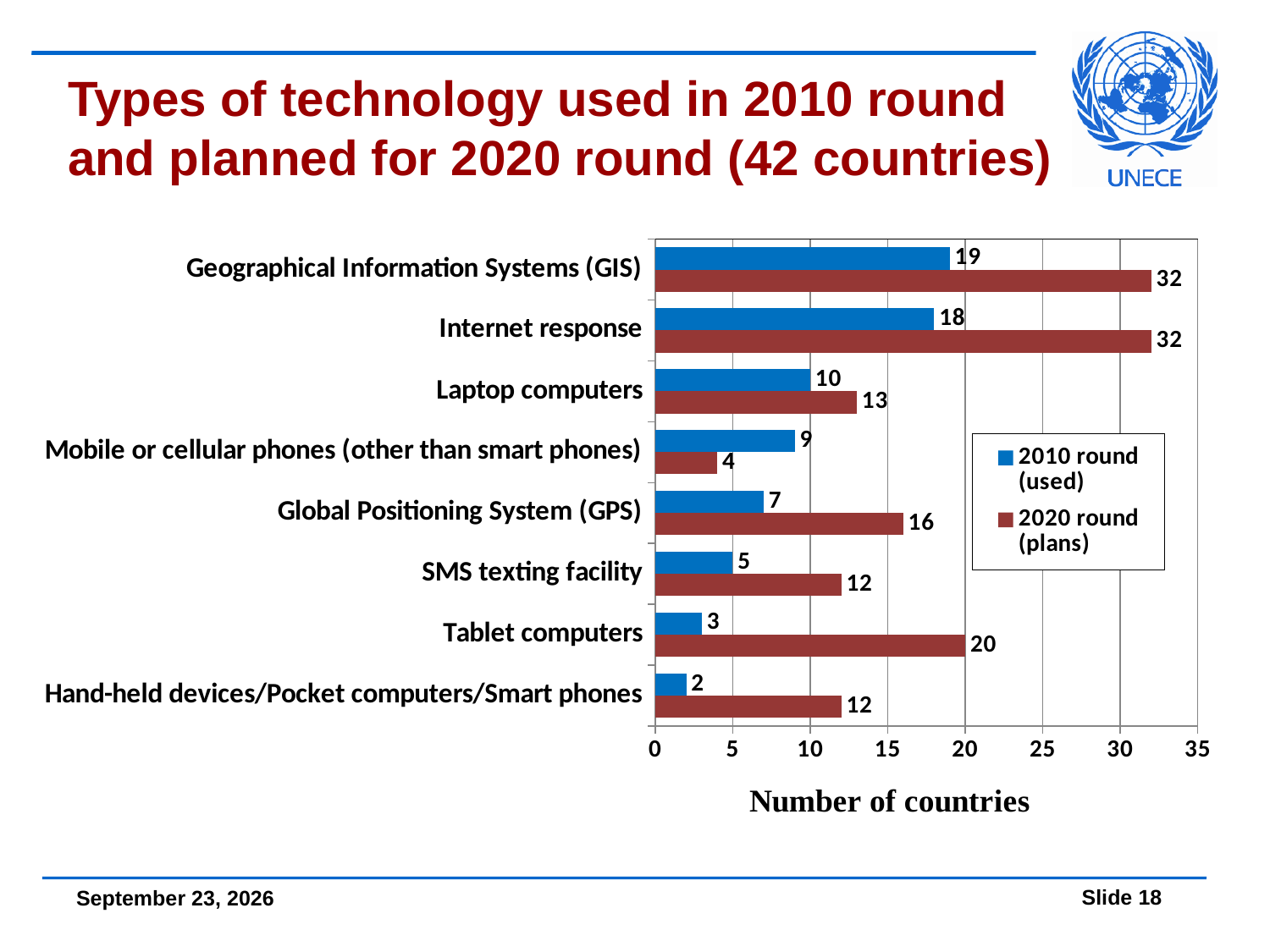
What is the value for Internet response in the 2010 round (used) series? 18 Which category has the lowest value in the 2020 round (plans) series? Mobile or cellular phones (other than smart phones) What is the value for Global Positioning System (GPS) in the 2020 round (plans) series? 16 For Mobile or cellular phones (other than smart phones), which series has the larger value: 2010 round (used) or 2020 round (plans)? 2010 round (used) What is the label of the horizontal axis? Number of countries Which category has the highest value in the 2010 round (used) series? Geographical Information Systems (GIS) What is the value for Tablet computers in the 2020 round (plans) series? 20 How many technology categories are shown in the chart? 8 How many series does the legend list? 2 What type of chart is shown on the slide? Bar chart What is the difference between the 2020 round (plans) and 2010 round (used) values for Tablet computers? 17 Which category has the lowest value in the 2010 round (used) series? Hand-held devices/Pocket computers/Smart phones